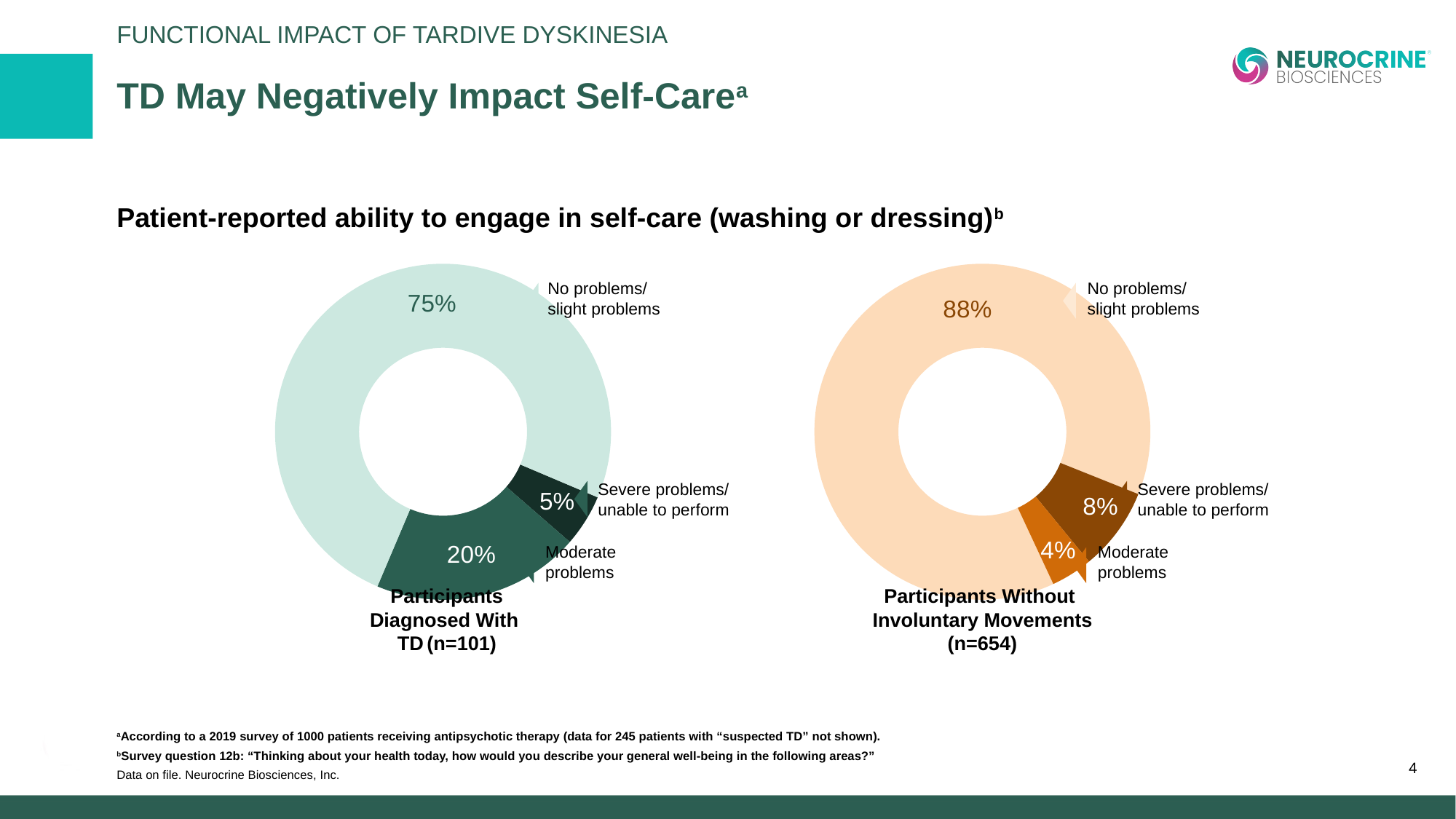
In the right chart (Participants Without Involuntary Movements), which category has the largest share? No problems/slight problems In the left chart (Participants Diagnosed With TD), what percentage reported moderate problems? 20% In the left chart (Participants Diagnosed With TD), what percentage reported no problems/slight problems with self-care? 75% In the right chart (Participants Without Involuntary Movements), what percentage reported no problems/slight problems with self-care? 88% How many categories does each donut chart on the slide show? 3 In the right chart (Participants Without Involuntary Movements), what percentage reported severe problems/unable to perform? 8% What is the sample size (n) shown for the left chart, Participants Diagnosed With TD? n=101 In the left chart (Participants Diagnosed With TD), which category has the smallest share? Severe problems/unable to perform What kind of chart is used on this slide? Donut (pie) chart Which chart shows a larger share for severe problems/unable to perform: the left chart (Participants Diagnosed With TD) or the right chart (Participants Without Involuntary Movements)? Participants Without Involuntary Movements What is the difference between the moderate problems share in the left chart (Participants Diagnosed With TD) and in the right chart (Participants Without Involuntary Movements)? 16 percentage points How many donut charts are on the slide? 2